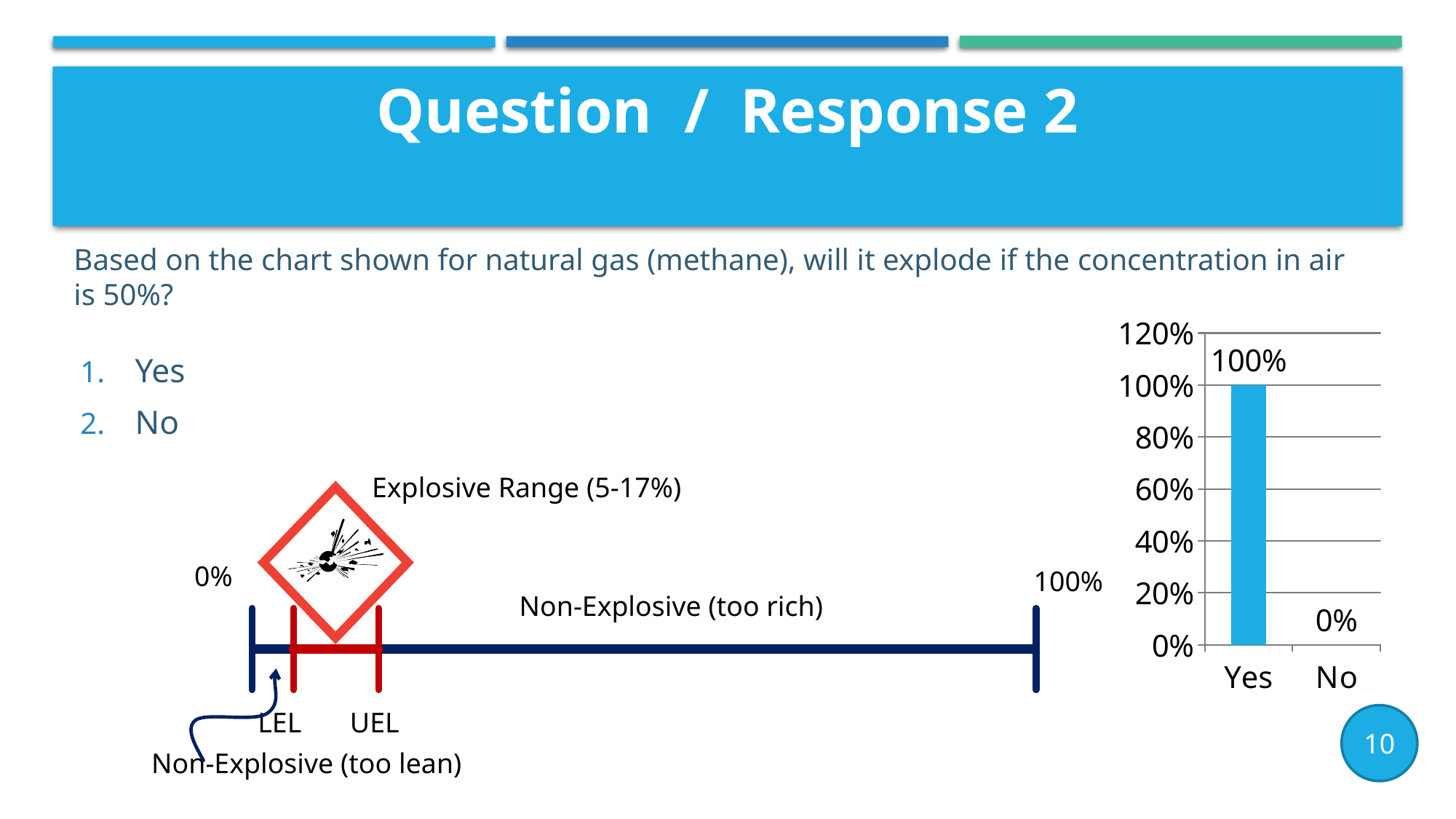
In the bar chart on the right, is the value for Yes greater or less than 80%? greater In the bar chart on the right, what is the difference between the values for Yes and No? 100% In the bar chart on the right, what is the value for No? 0% In the bar chart on the right, what is the value for Yes? 100% In the bar chart on the right, which category has the highest value? Yes In the bar chart on the right, which category has the lowest value? No In the bar chart on the right, what is the highest value shown on the vertical axis? 120% In the bar chart on the right, what colour is the bar for Yes? light blue In the bar chart on the right, which is larger, the value for Yes or the value for No? Yes How many categories are shown in the bar chart on the right? 2 What kind of chart is shown on the right of the slide? bar chart